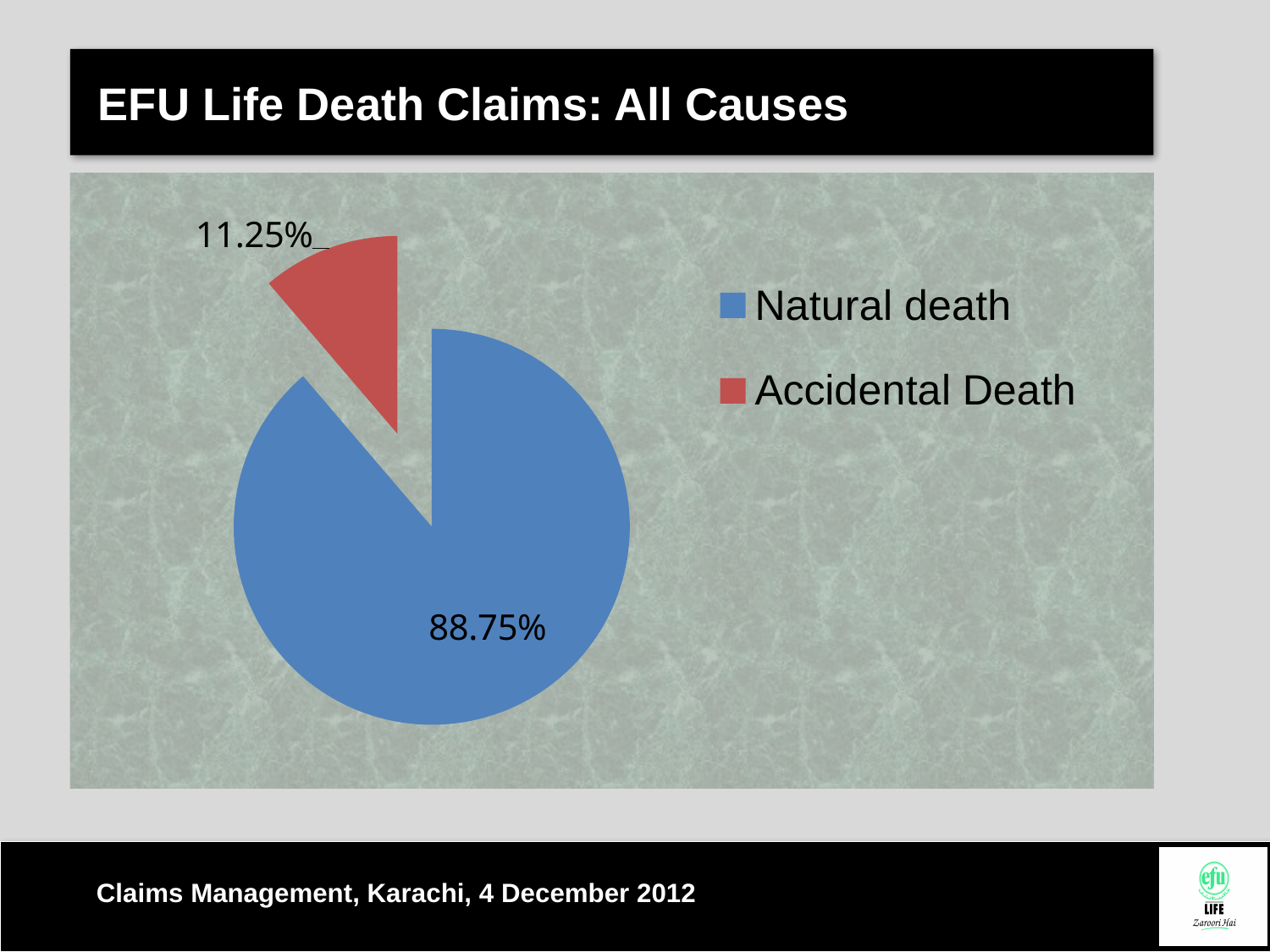
How many entries does the legend list? 2 Which cause accounts for the largest share of death claims? Natural death How many slices does the pie chart have? 2 What is the difference in percentage points between the Natural death and Accidental Death shares? 77.5 Which is larger: the share for Natural death or the share for Accidental Death? Natural death What is the title of the chart on the slide? EFU Life Death Claims: All Causes What is the combined share of the Natural death and Accidental Death slices? 100% Which cause accounts for the smallest share of death claims? Accidental Death What share of EFU Life death claims is attributed to Natural death? 88.75% What kind of chart is shown on the slide? Pie chart What colour is the Accidental Death slice? Red What share of EFU Life death claims is attributed to Accidental Death? 11.25%